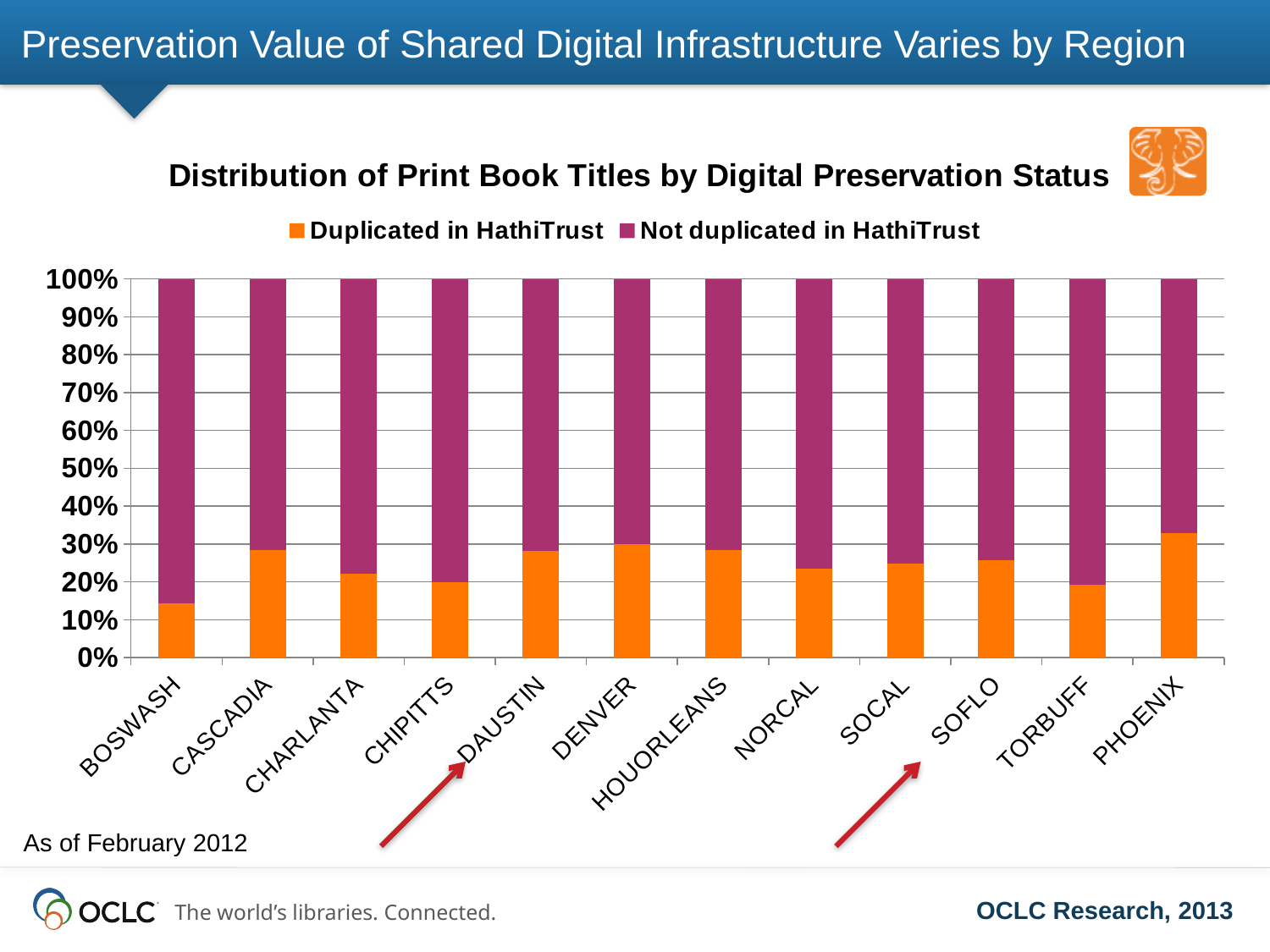
How many regions are shown along the x axis of the chart? 12 Is the share of titles not duplicated in HathiTrust for BOSWASH greater or less than 80%? greater Which region has the lowest share of titles duplicated in HathiTrust? BOSWASH Is the share of titles duplicated in HathiTrust for BOSWASH greater or less than 20%? less How many series does the chart's legend list? 2 Which region has a larger share of titles duplicated in HathiTrust, DENVER or TORBUFF? DENVER Is the share of titles duplicated in HathiTrust for CASCADIA greater or less than 20%? greater What is the total height of the stacked bar for NORCAL? 100% What kind of chart is shown on the slide? stacked bar chart What is the title of the chart? Distribution of Print Book Titles by Digital Preservation Status Which region has the highest share of titles duplicated in HathiTrust? PHOENIX